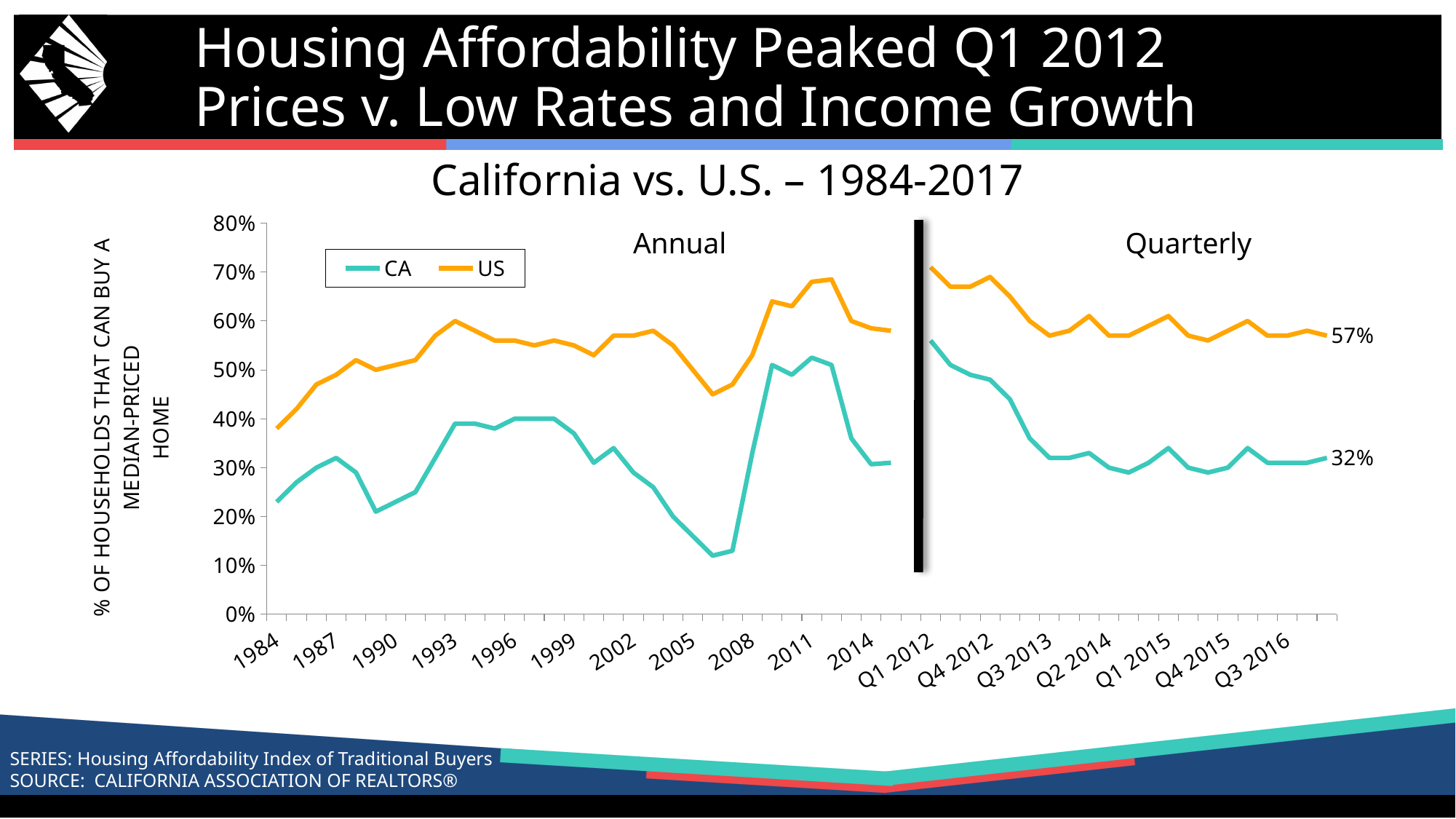
What are the two entries in the chart legend? CA and US How many series does the legend list? 2 Is the value for CA in 2007 greater or less than 20%? less What is the title of the chart? California vs. U.S. – 1984-2017 At the right end of the quarterly section, which series has the larger labelled value, CA or US? US Does the CA series rise or fall between 2005 and 2007? fall Is the value for CA in 1984 greater or less than 30%? less What is the final labelled value for the CA series at the right end of the quarterly section? 32% What kind of chart is shown on the slide? line chart What is the final labelled value for the US series at the right end of the quarterly section? 57% What is the difference between the final labelled US value and the final labelled CA value? 25 percentage points Is the value for US in 1984 greater or less than 50%? less